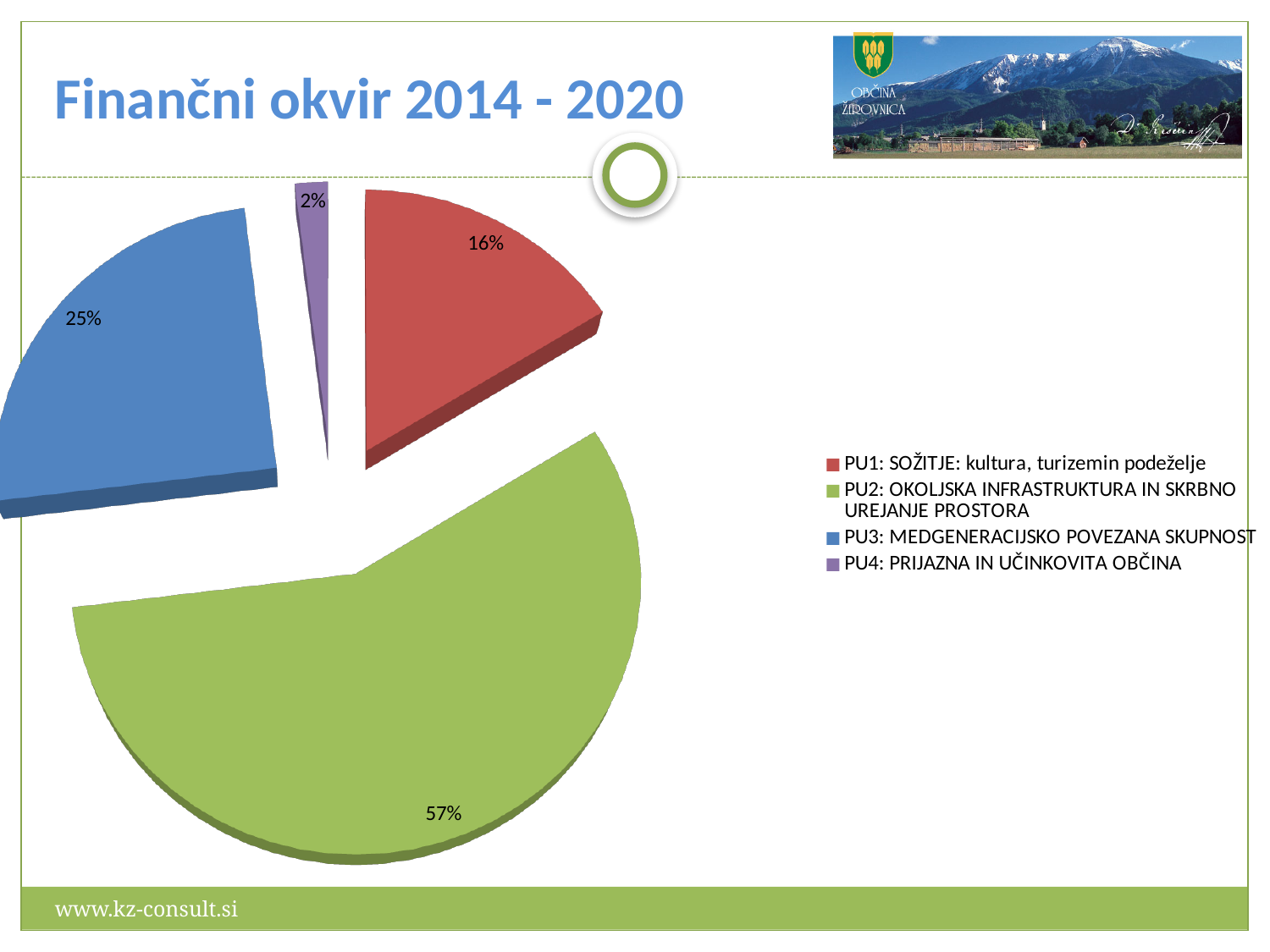
What share of the pie does PU1: SOŽITJE: kultura, turizem in podeželje have? 16% What share of the pie does PU3: MEDGENERACIJSKO POVEZANA SKUPNOST have? 25% What is the difference in percentage points between the PU3 slice and the PU1 slice? 9 How many slices does the pie chart have? 4 What kind of chart is shown on the slide? pie chart What is the difference in percentage points between the PU2 slice and the PU3 slice? 32 What share of the pie does PU2: OKOLJSKA INFRASTRUKTURA IN SKRBNO UREJANJE PROSTORA have? 57% Which category has the largest slice of the pie? PU2: OKOLJSKA INFRASTRUKTURA IN SKRBNO UREJANJE PROSTORA What colour is the slice for PU2: OKOLJSKA INFRASTRUKTURA IN SKRBNO UREJANJE PROSTORA? green Which category has the smallest slice of the pie? PU4: PRIJAZNA IN UČINKOVITA OBČINA Which is larger, the PU1 slice or the PU3 slice? PU3 What share of the pie does PU4: PRIJAZNA IN UČINKOVITA OBČINA have? 2%